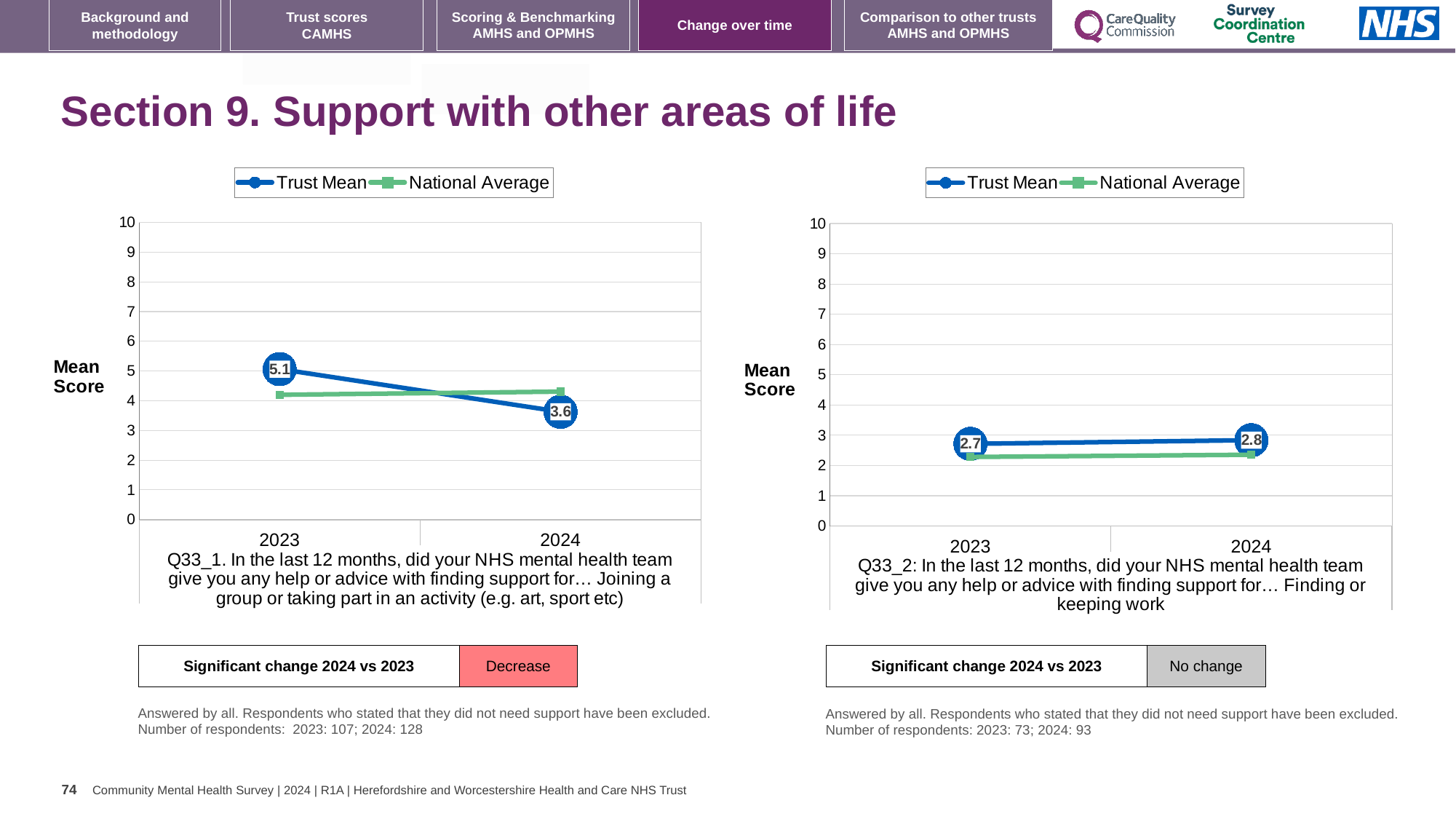
In the left chart (Q33_1), does the Trust Mean rise or fall from 2023 to 2024? fall In the right chart (Q33_2), what is the Trust Mean for 2023? 2.7 In the left chart (Q33_1), what is the Trust Mean for 2023? 5.1 In the left chart (Q33_1), is the National Average for 2023 greater or less than 5? less In the left chart (Q33_1), what is the Trust Mean for 2024? 3.6 In the right chart (Q33_2), what is the Trust Mean for 2024? 2.8 In the right chart (Q33_2), does the Trust Mean rise or fall from 2023 to 2024? rise How many series does the legend of the left chart (Q33_1) list? 2 In the left chart (Q33_1), which is larger in 2023, the Trust Mean or the National Average? Trust Mean What kind of chart is the right chart (Q33_2)? line chart In the left chart (Q33_1), by how much did the Trust Mean change from 2023 to 2024? 1.5 In the right chart (Q33_2), is the National Average for 2024 greater or less than 3? less